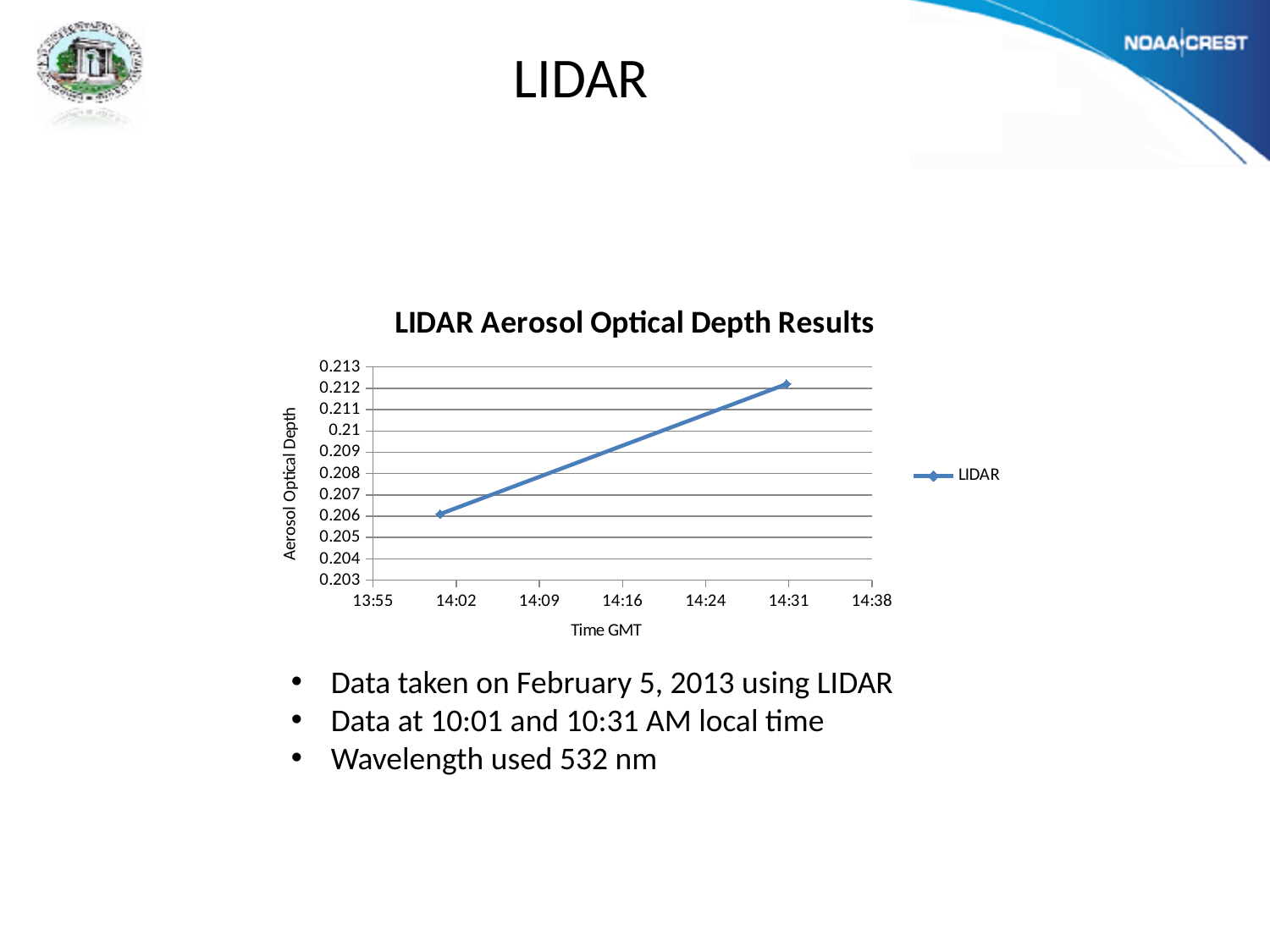
Is the aerosol optical depth of the later (second) data point greater or less than 0.213? less Is the aerosol optical depth of the earlier (first) data point greater or less than 0.207? less What type of chart is shown on the slide? line chart Is the aerosol optical depth of the later (second) data point greater or less than 0.211? greater Which data point has the higher aerosol optical depth, the earlier one or the later one? the later one How many data points are plotted on the LIDAR line? 2 How many series does the legend list? 1 What is the label of the x axis? Time GMT Does the aerosol optical depth rise or fall as time increases along the x axis? rise What is the title of the chart? LIDAR Aerosol Optical Depth Results